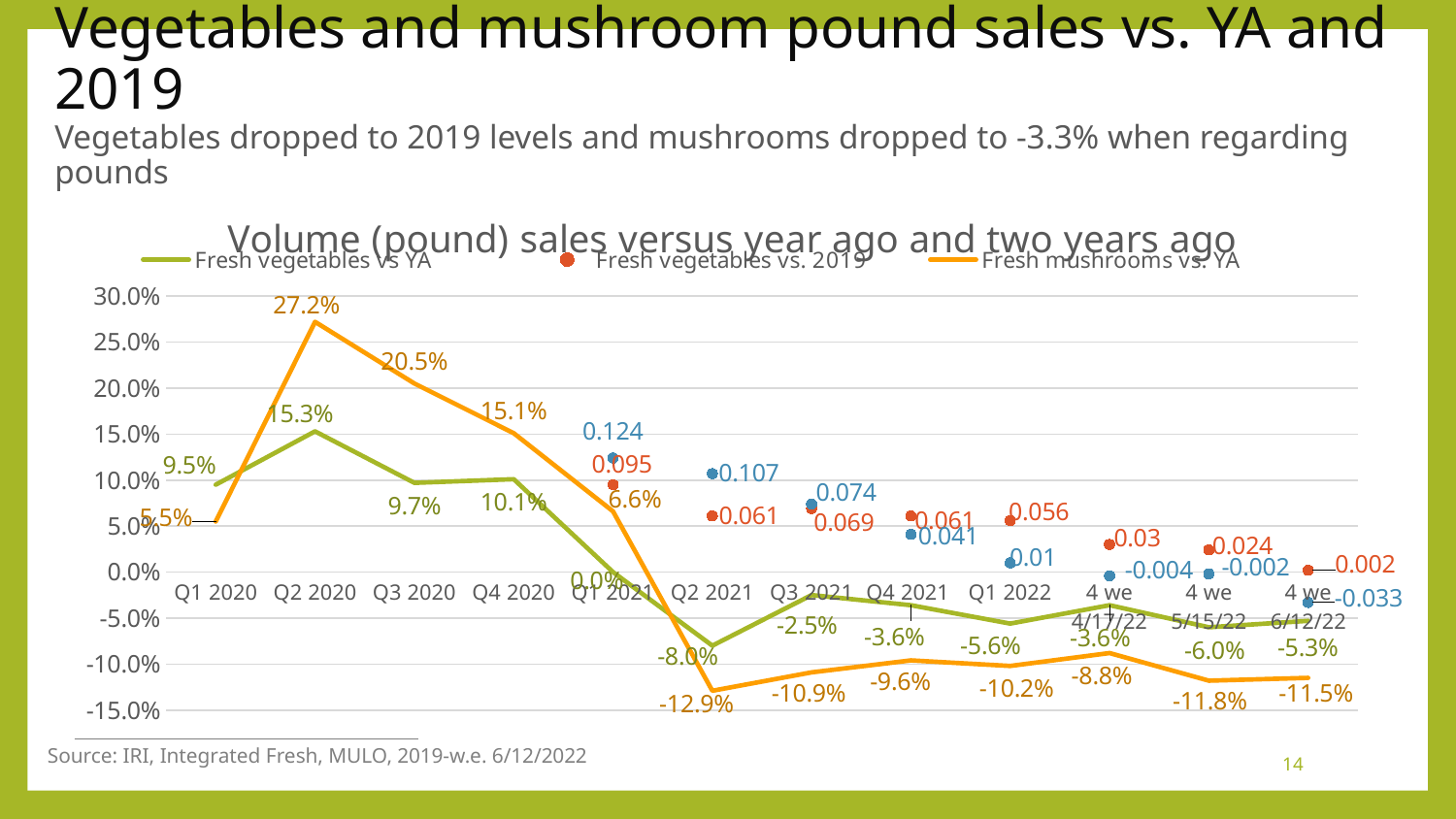
What is the value for Fresh vegetables vs. 2019 in Q1 2022? 0.056 In which period is Fresh mushrooms vs. YA at its lowest? Q2 2021 What is the value for Fresh mushrooms vs. YA in Q2 2020? 27.2% In which period is Fresh vegetables vs YA at its lowest? Q2 2021 How many time periods are plotted along the x axis? 12 Does Fresh mushrooms vs. YA rise or fall from Q2 2020 to Q2 2021? Fall How many series does the chart legend list? 3 What is the value for Fresh vegetables vs YA in Q2 2020? 15.3% In Q1 2020, which is larger: Fresh vegetables vs YA or Fresh mushrooms vs. YA? Fresh vegetables vs YA What is the difference between Fresh mushrooms vs. YA and Fresh vegetables vs YA in Q2 2020? 11.9 percentage points In which period is Fresh mushrooms vs. YA at its highest? Q2 2020 What kind of chart is shown on the slide? Line chart